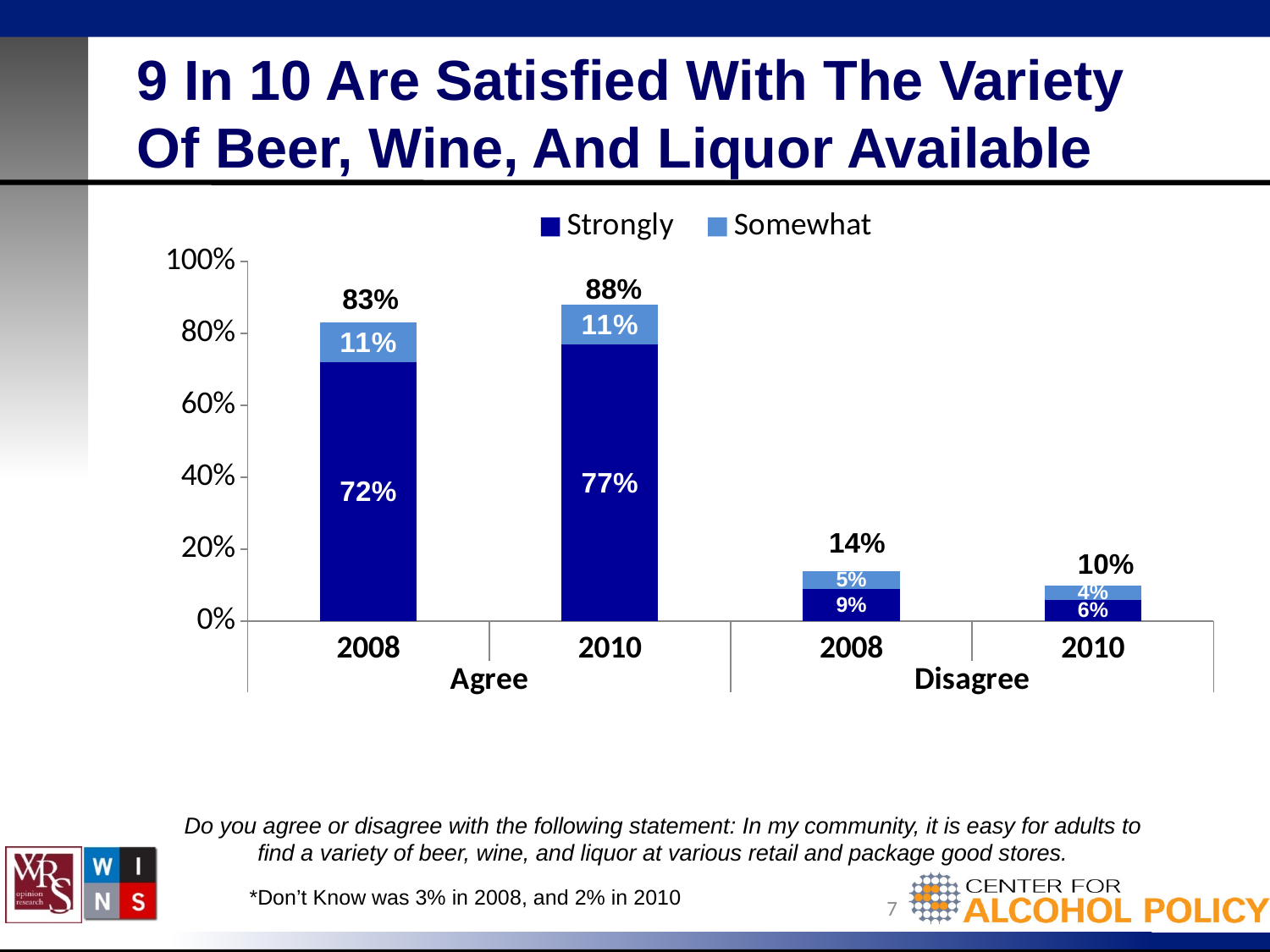
How many series does the legend list? 2 Which is larger, the Disagree total in 2008 or in 2010? 2008 How many bars are shown in the chart? 4 Which series is shown in dark blue? Strongly What kind of chart is shown? Stacked bar chart Which bar has the highest total? Agree 2010 What is the total for the Agree 2008 stacked bar? 83% What is the Somewhat value for Disagree in 2008? 5% What is the difference between the Strongly values for Agree in 2010 and 2008? 5% What is the Strongly value for Agree in 2010? 77% Which bar has the lowest total? Disagree 2010 What is the total for the Disagree 2010 stacked bar? 10%